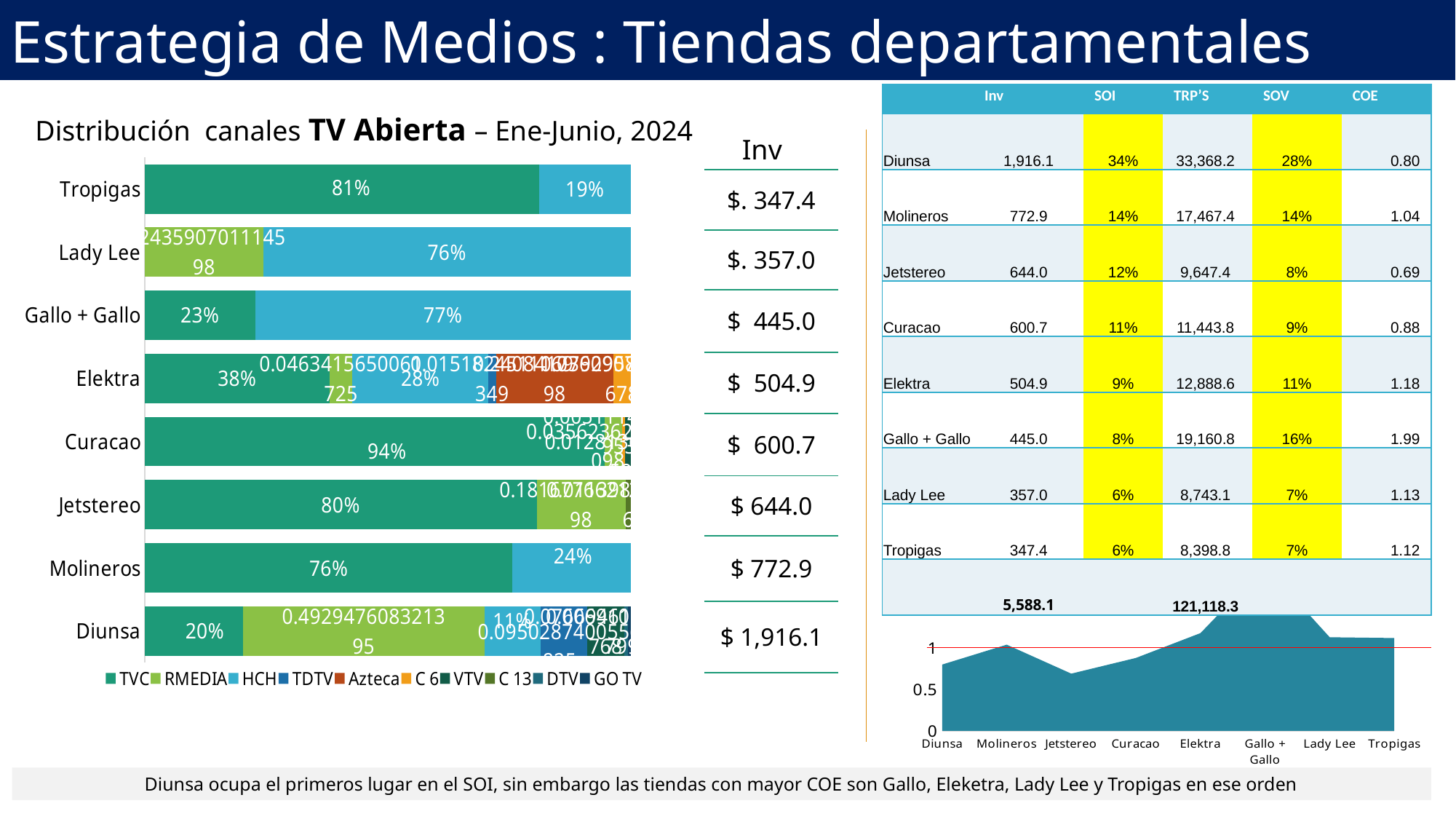
In the 'Distribución canales TV Abierta' chart, which is larger for Elektra: the TVC share or the HCH share? TVC In the 'Distribución canales TV Abierta' chart, what is the difference between the TVC share of Tropigas and the TVC share of Gallo + Gallo? 58% In the 'Distribución canales TV Abierta' chart, what share does TVC have for Curacao? 94% In the 'Distribución canales TV Abierta' chart, what share does HCH have for Gallo + Gallo? 77% In the 'Distribución canales TV Abierta' chart, which store has the highest TVC share? Curacao How many stores are shown in the 'Distribución canales TV Abierta' chart? 8 In the 'Distribución canales TV Abierta' chart, what share does TVC have for Tropigas? 81% What type of chart is the 'Distribución canales TV Abierta' chart? Stacked bar chart In the area chart at the bottom right of the slide, is the value for Gallo + Gallo greater or less than 1? greater How many series does the legend of the 'Distribución canales TV Abierta' chart list? 10 In the 'Distribución canales TV Abierta' chart, what share does HCH have for Molineros? 24%